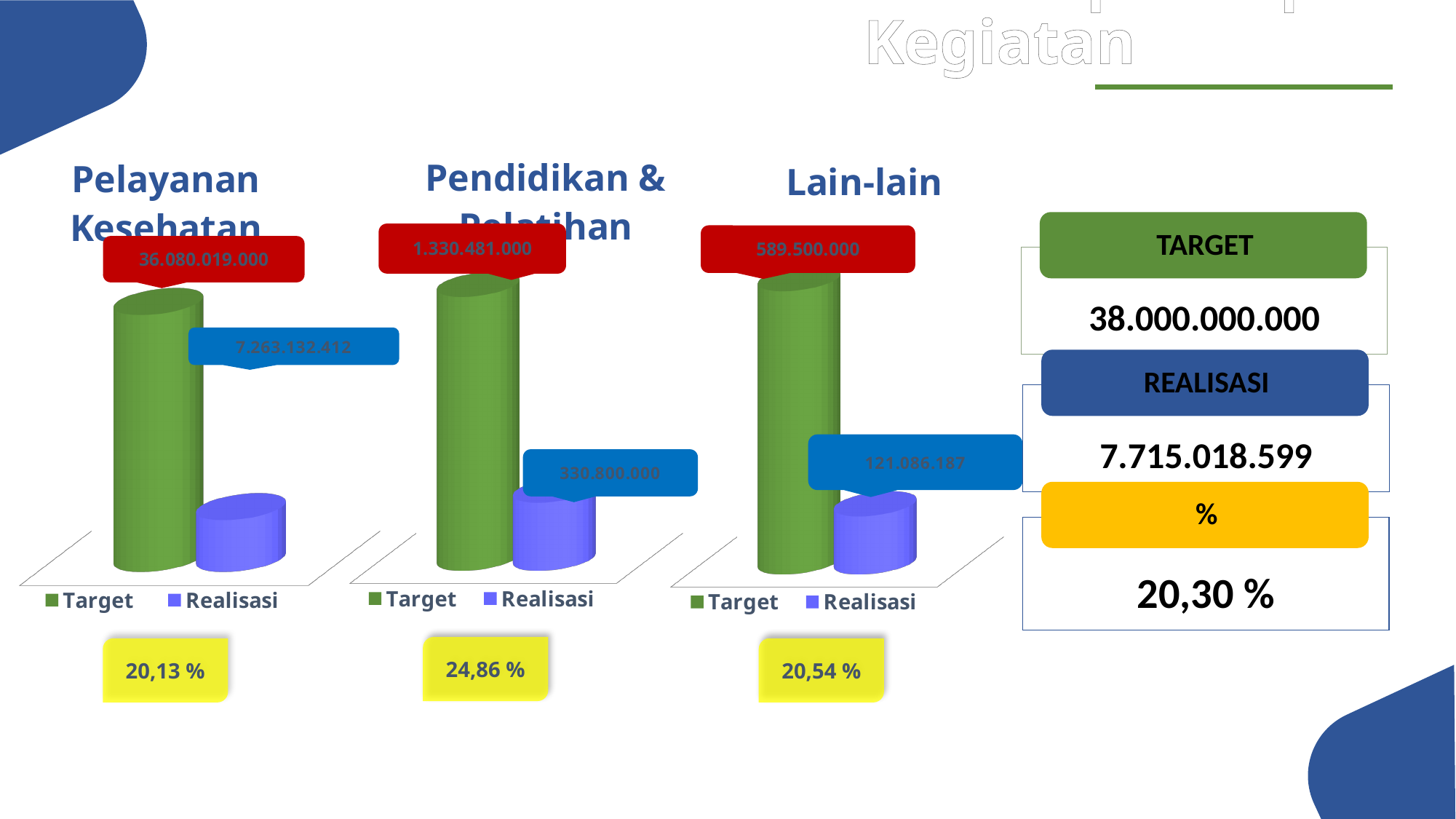
What kind of chart is the Pendidikan & Pelatihan chart? Bar chart In the Pelayanan Kesehatan chart, what is the value of the Target bar? 36.080.019.000 How many series does the legend of the Pelayanan Kesehatan chart list? 2 In the Pendidikan & Pelatihan chart, what is the difference between the Target and Realisasi values? 999.681.000 In the Lain-lain chart, what is the value of the Target bar? 589.500.000 In the Lain-lain chart, what is the value of the Realisasi bar? 121.086.187 In the Pelayanan Kesehatan chart, what is the value of the Realisasi bar? 7.263.132.412 In the Pendidikan & Pelatihan chart, what is the value of the Realisasi bar? 330.800.000 In the Lain-lain chart, which series is larger, Target or Realisasi? Target In the Pendidikan & Pelatihan chart, what is the value of the Target bar? 1.330.481.000 What colour is the Target bar in the Lain-lain chart? Green In the Lain-lain chart, what is the difference between the Target and Realisasi values? 468.413.813